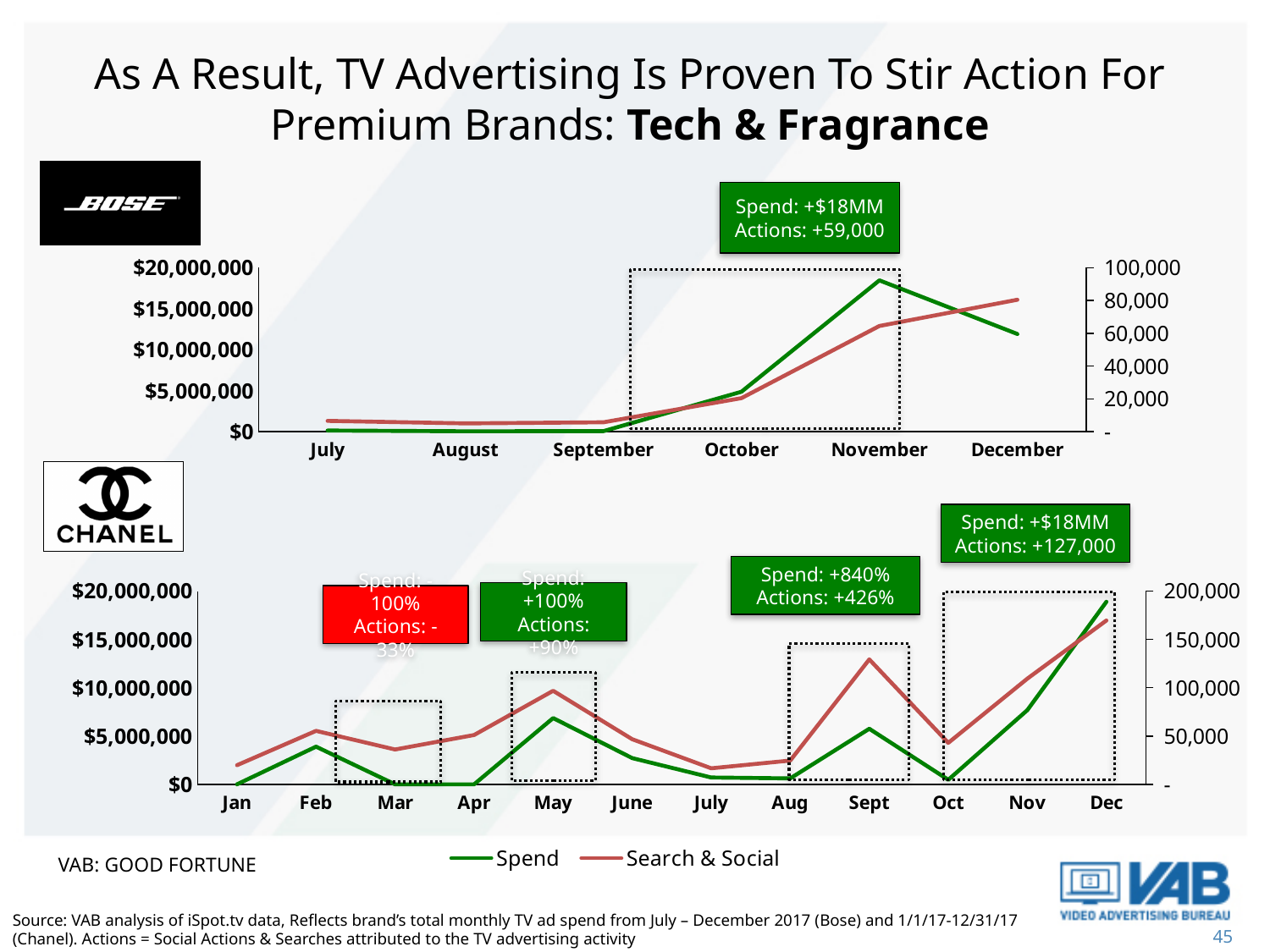
In the Chanel chart, is the Search & Social value for Sept greater or less than 100,000? greater How many months are shown on the x axis of the Bose chart? 6 In the Bose chart, in which month does Search & Social reach its highest value? December According to the annotation on the Chanel chart, what is the Actions increase for the Oct–Dec period? +127,000 In the Chanel chart, does Search & Social rise or fall from Sept to Oct? fall In the Chanel chart, in which month does Spend reach its highest value? Dec In the Bose chart, is the Spend value for November greater or less than $15,000,000? greater What type of chart is the Bose chart at the top of the slide? Line chart In the Bose chart, is the Spend value for July greater or less than $5,000,000? less How many series does the legend at the bottom of the slide list? 2 In the Bose chart, in which month does Spend reach its highest value? November How many months are shown on the x axis of the Chanel chart? 12